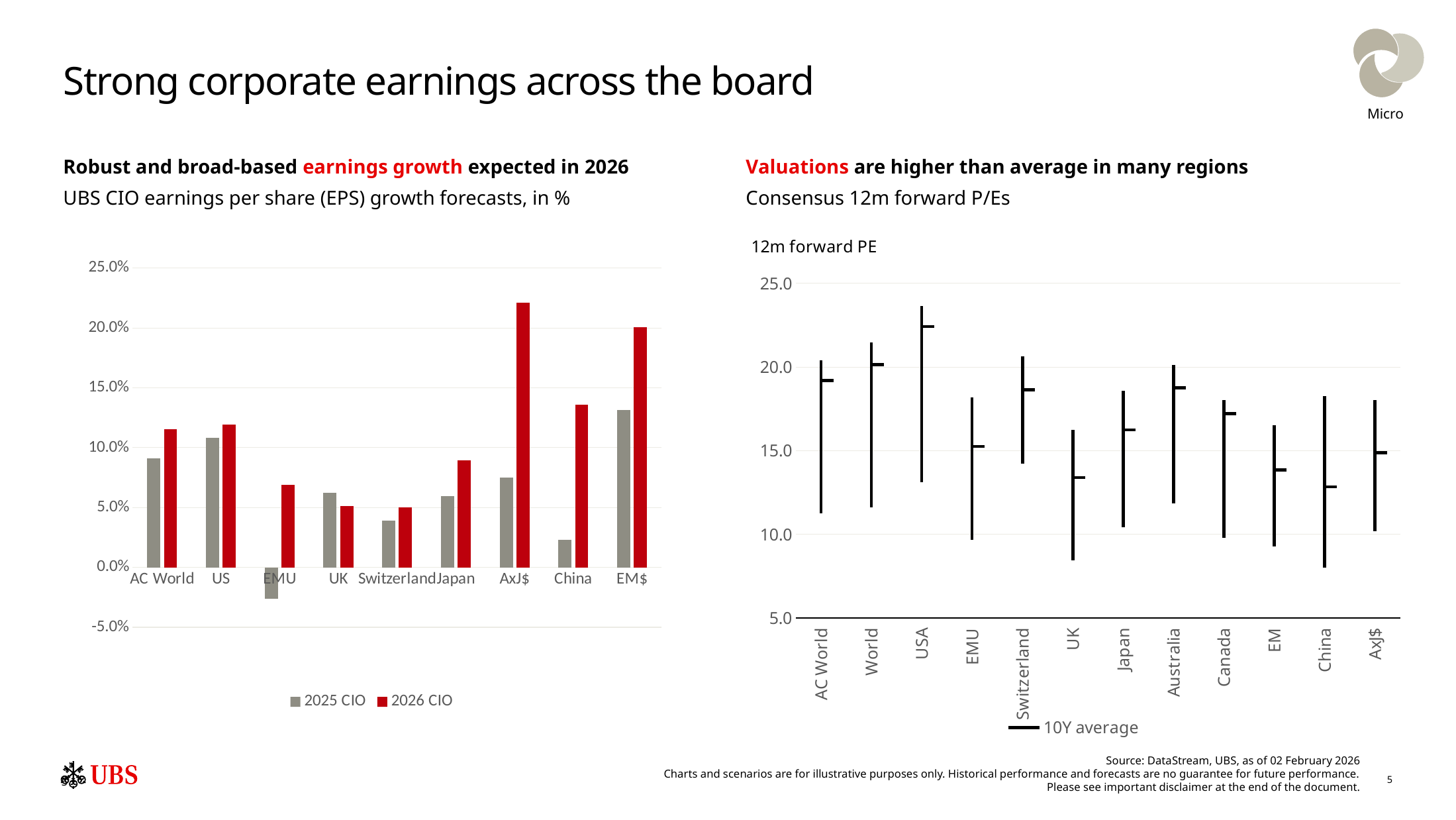
In the left EPS growth chart, which region has the lowest 2025 CIO forecast? EMU In the left EPS growth chart, is the 2026 CIO value for AxJ$ greater or less than 20.0%? greater What are the two legend entries of the left EPS growth chart? 2025 CIO and 2026 CIO In the left EPS growth chart, which region has the highest 2026 CIO forecast? AxJ$ How many series does the legend of the left EPS growth chart list? 2 In the left EPS growth chart, which is larger: the 2026 CIO value for US or the 2026 CIO value for UK? US How many regions are shown on the x axis of the right 12m forward PE chart? 12 How many regions are shown on the x axis of the left EPS growth chart? 9 In the right 12m forward PE chart, which region has the highest 10Y average? USA In the left EPS growth chart, is the 2025 CIO value for EMU greater or less than 0.0%? less What kind of chart is the left chart showing UBS CIO EPS growth forecasts? bar chart